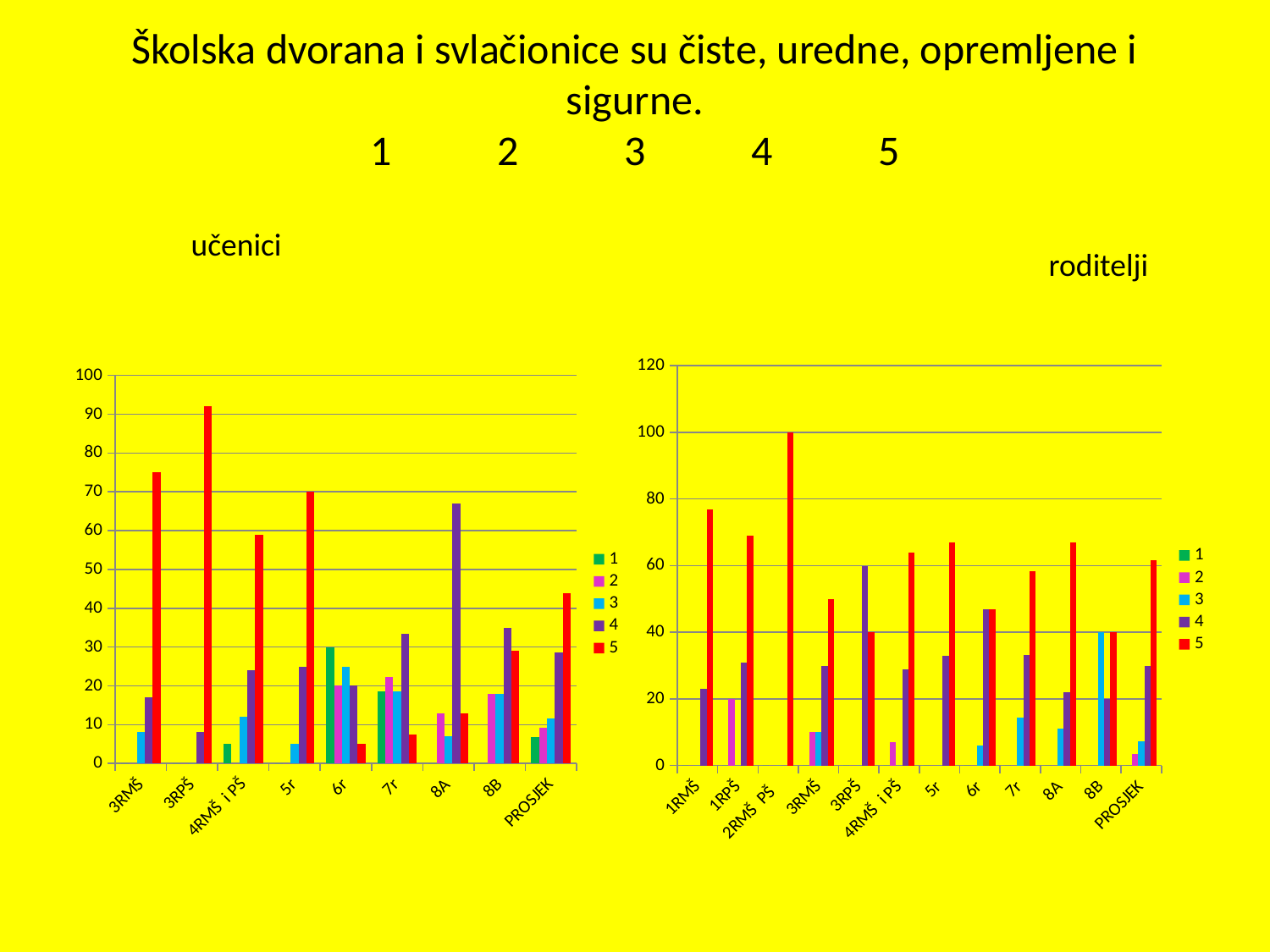
In the right chart (roditelji), which is larger: the series 5 value for 1RMŠ or for 1RPŠ? 1RMŠ In the right chart (roditelji), is the series 5 value for 2RMŠ PŠ greater or less than 80? greater How many categories are shown on the x axis of the right chart (roditelji)? 12 What colour represents series 5 in the legend of the right chart (roditelji)? red In the left chart (učenici), is the series 5 value for 3RPŠ greater or less than 80? greater In the right chart (roditelji), which category has the tallest bar for series 5? 2RMŠ PŠ In the left chart (učenici), which category has the tallest bar for series 5? 3RPŠ How many categories are shown on the x axis of the left chart (učenici)? 9 In the left chart (učenici), which is larger: the series 5 value for 3RMŠ or for 4RMŠ i PŠ? 3RMŠ In the left chart (učenici), is the series 5 value for 6r greater or less than 10? less What kind of chart is the left chart (učenici)? bar chart How many series does the legend of the left chart (učenici) list? 5